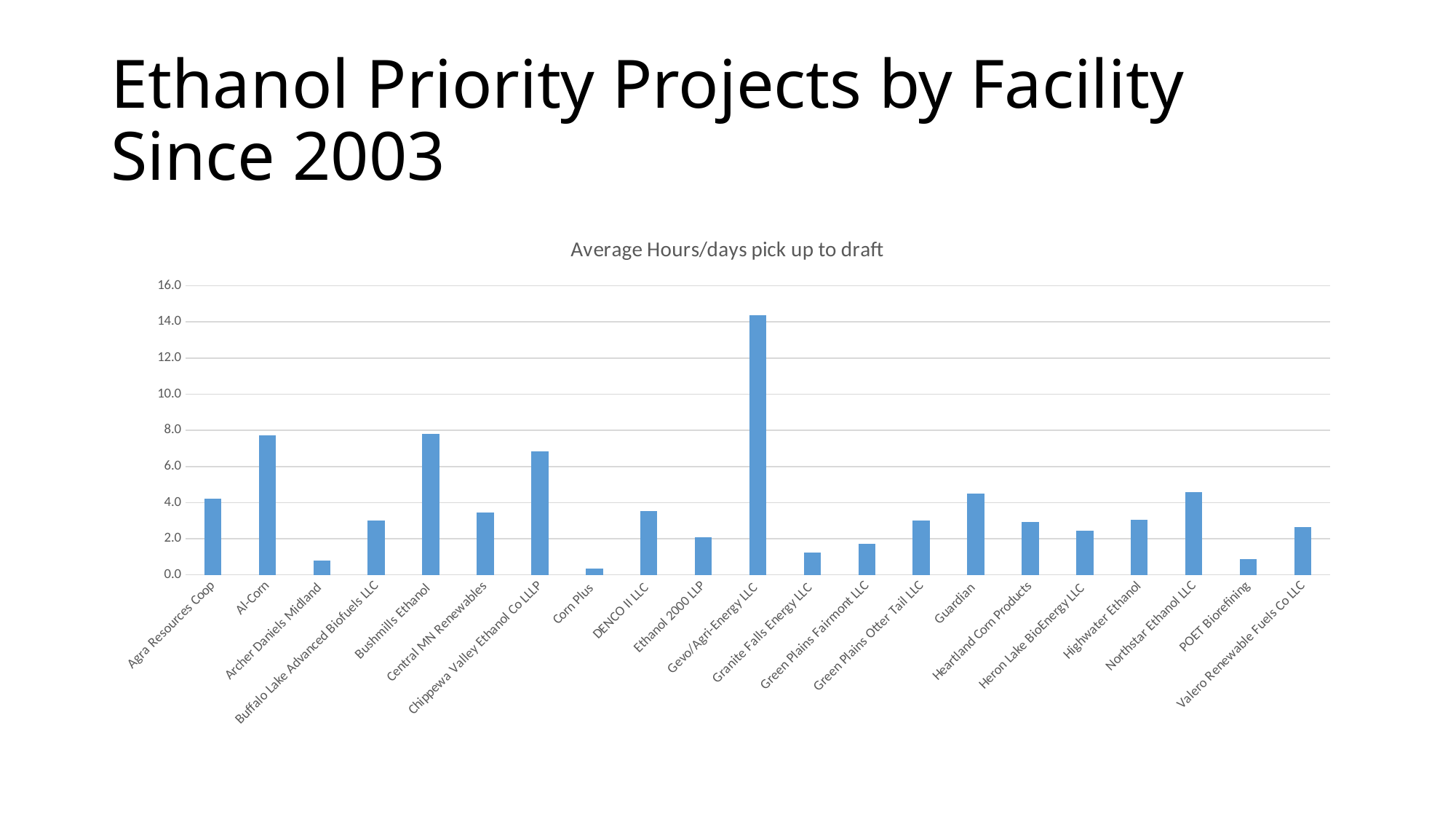
How many facilities are shown on the x axis of the chart? 21 Which has a larger value, Chippewa Valley Ethanol Co LLLP or Central MN Renewables? Chippewa Valley Ethanol Co LLLP Is the value for Granite Falls Energy LLC greater or less than 2.0? less What type of chart is shown on the slide? bar chart Is the value for Gevo/Agri-Energy LLC greater or less than 12.0? greater Is the value for Archer Daniels Midland greater or less than 2.0? less Which facility has the highest average hours/days pick up to draft? Gevo/Agri-Energy LLC Which has a larger value, Guardian or Heartland Corn Products? Guardian Which facility has the lowest average hours/days pick up to draft? Corn Plus What is the title of the chart? Average Hours/days pick up to draft